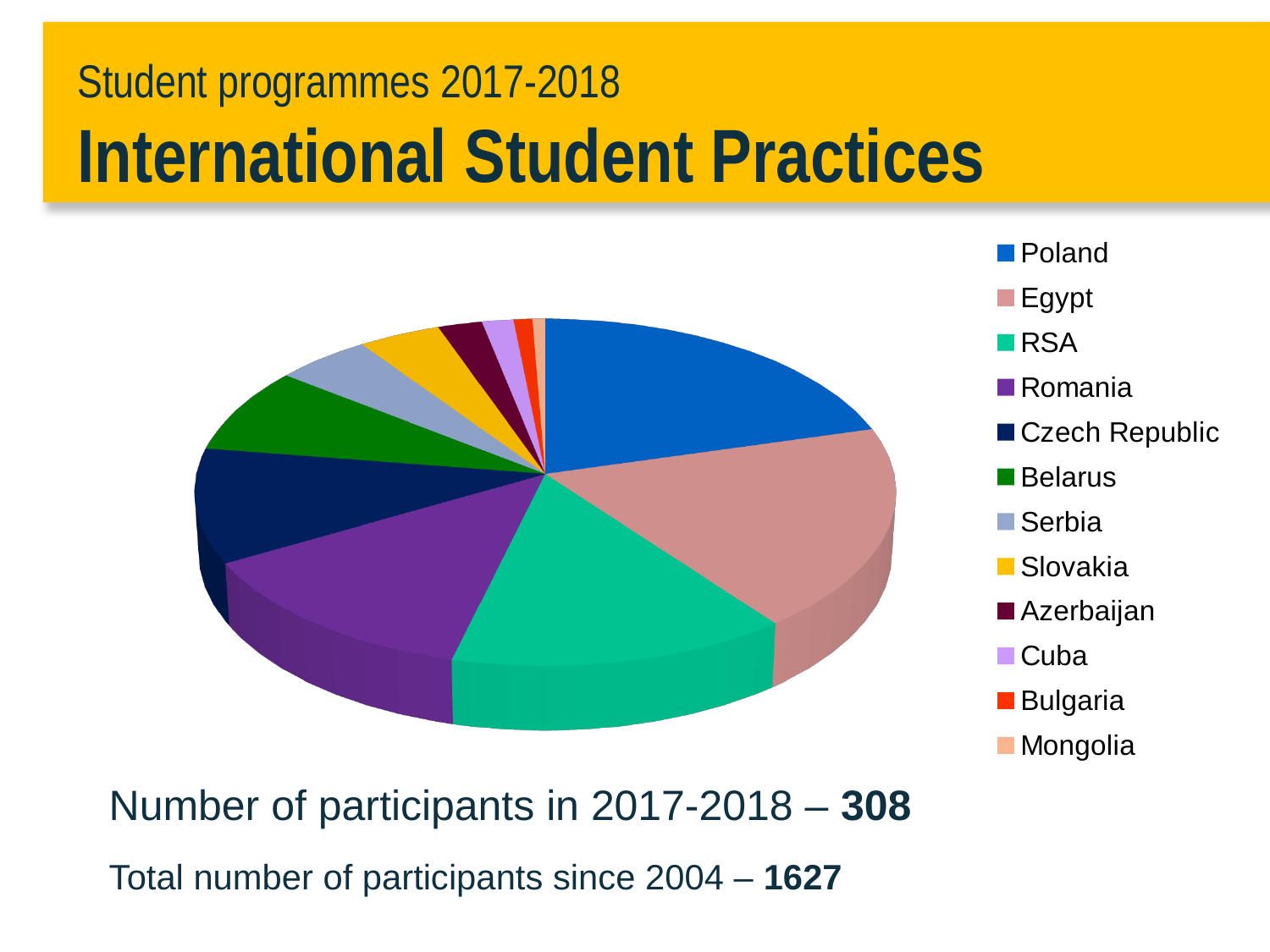
Which slice is larger in the pie chart, Egypt or Azerbaijan? Egypt What colour is the Poland slice in the pie chart? blue Which slice is larger in the pie chart, Poland or Serbia? Poland Which slice is larger in the pie chart, Belarus or Cuba? Belarus Which country has the smallest slice of the pie chart? Mongolia Which country is listed first in the legend of the pie chart? Poland What kind of chart is shown on the slide? pie chart How many countries are listed in the legend of the pie chart? 12